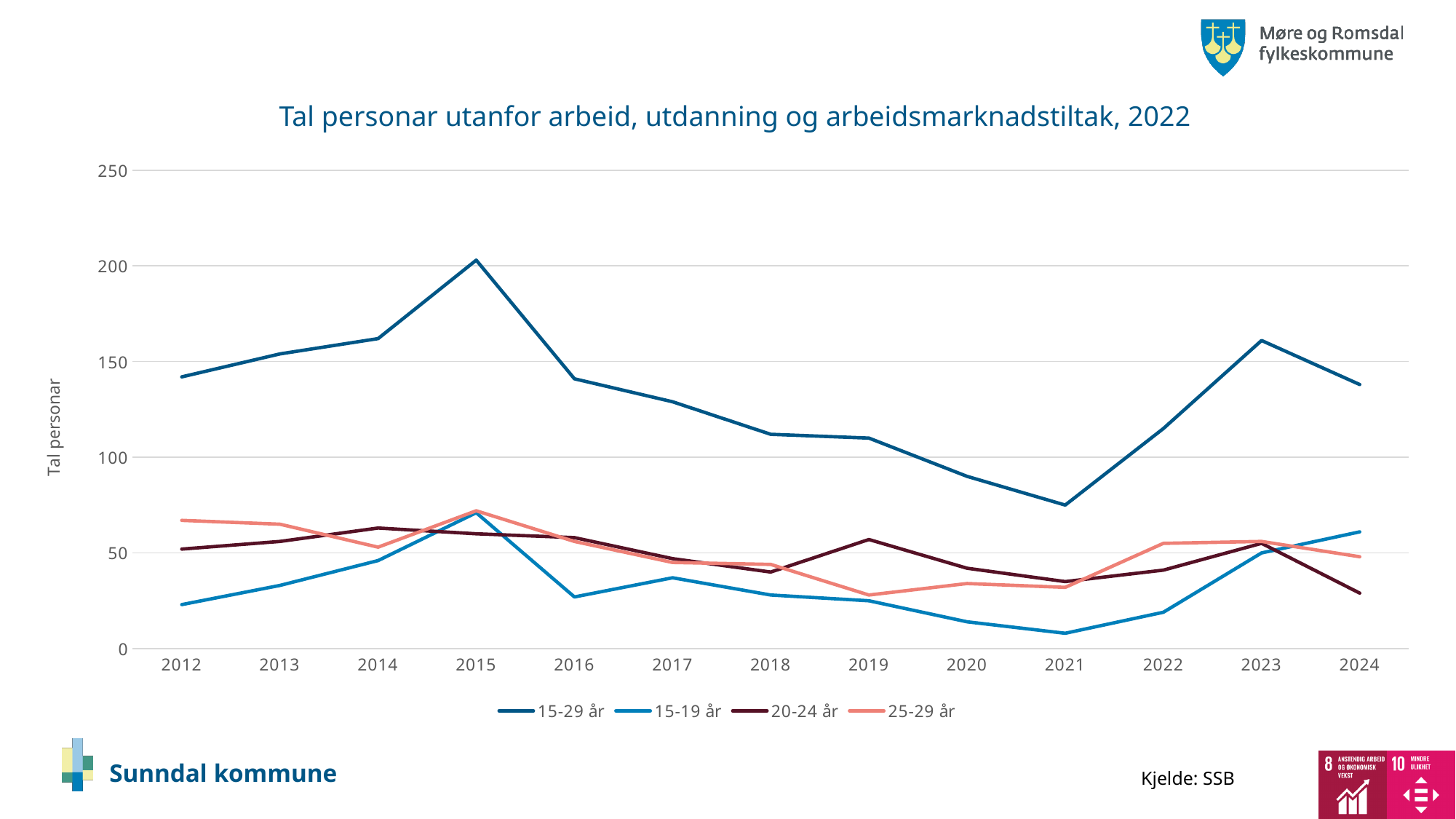
In which year does the 15-29 år series reach its highest value? 2015 Is the value for 15-29 år in 2023 greater or less than 150? greater How many years are shown along the x axis? 13 What kind of chart is shown on the slide? line chart Is the value for 15-29 år in 2021 greater or less than 100? less How many series does the legend list? 4 What is the label on the y axis? Tal personar In which year does the 15-29 år series reach its lowest value? 2021 Is the value for 20-24 år in 2024 greater or less than 50? less In which year does the 15-19 år series reach its lowest value? 2021 Does the 15-29 år series rise or fall between 2015 and 2021? fall Which is larger in 2016: the value for 15-19 år or the value for 25-29 år? 25-29 år